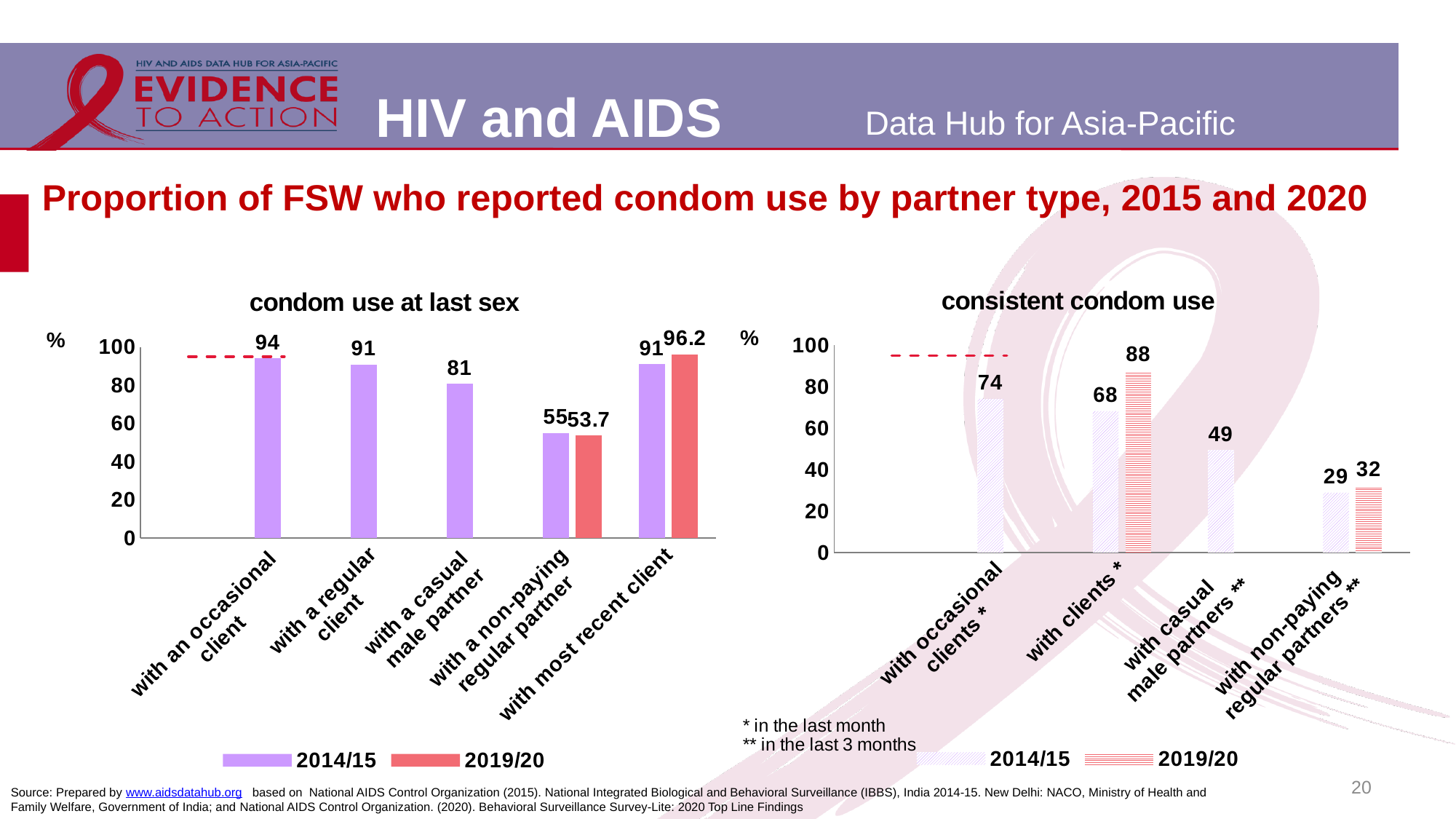
In the 'consistent condom use' chart, what is the difference between the 2019/20 and 2014/15 values for 'with clients'? 20 In the 'consistent condom use' chart, which category has the lowest 2014/15 value? with non-paying regular partners In the 'condom use at last sex' chart, how many categories are shown on the x axis? 5 In the 'condom use at last sex' chart, what is the difference between the 2019/20 and 2014/15 values for 'with most recent client'? 5.2 In the 'consistent condom use' chart, is the 2014/15 value for 'with occasional clients' larger or smaller than the 2014/15 value for 'with clients'? larger In the 'condom use at last sex' chart, what is the 2019/20 value for 'with most recent client'? 96.2 In the 'condom use at last sex' chart, which category has the lowest 2014/15 value? with a non-paying regular partner In the 'condom use at last sex' chart, what is the 2014/15 value for 'with an occasional client'? 94 How many series does the legend of the 'consistent condom use' chart list? 2 In the 'consistent condom use' chart, what is the 2014/15 value for 'with casual male partners'? 49 In the 'condom use at last sex' chart, what is the 2019/20 value for 'with a non-paying regular partner'? 53.7 In the 'consistent condom use' chart, what is the 2019/20 value for 'with clients'? 88